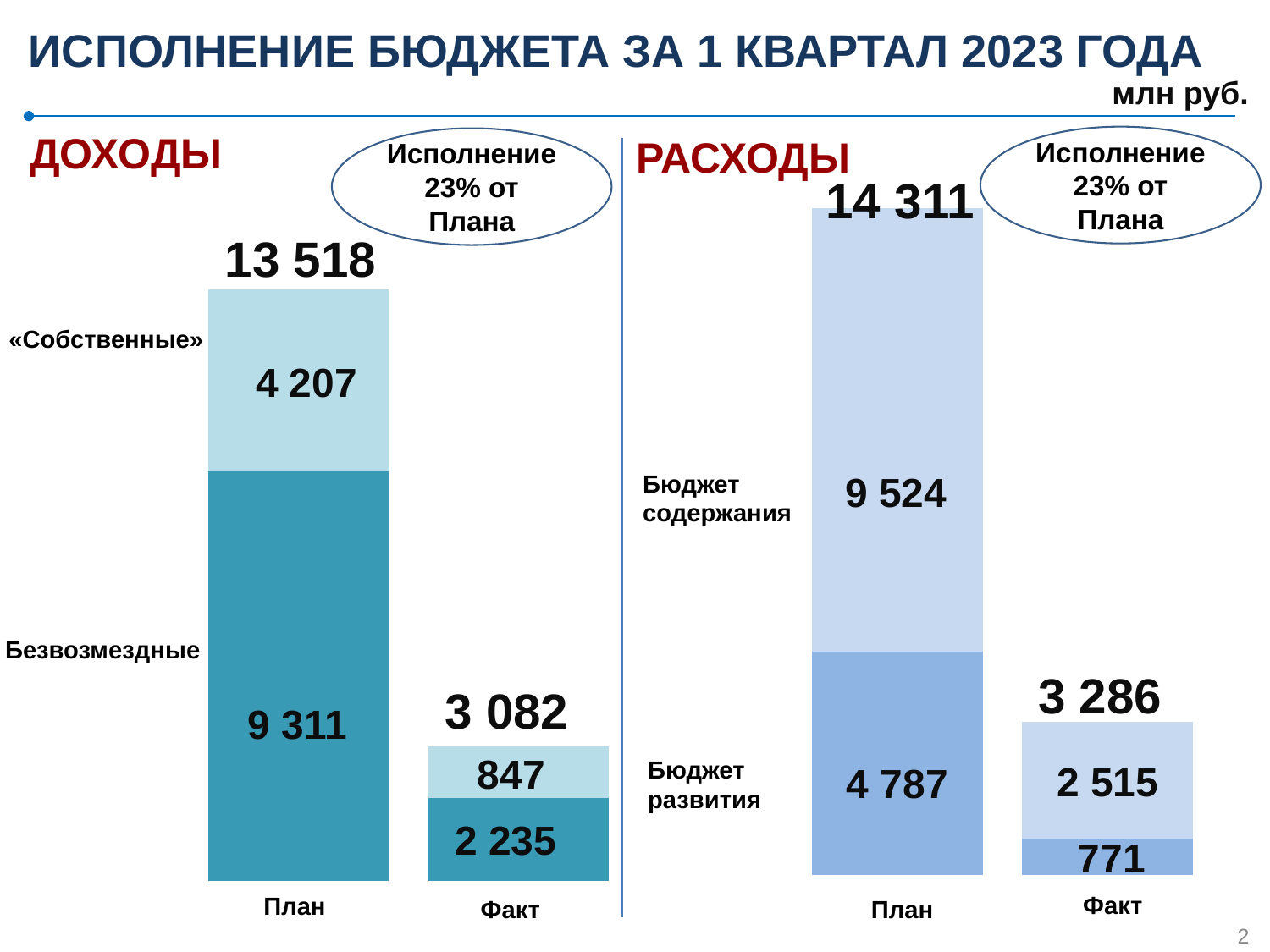
In the ДОХОДЫ chart, what is the value of Безвозмездные for Факт? 2 235 In the ДОХОДЫ chart, what is the total of the План bar? 13 518 In the РАСХОДЫ chart, what is the value of Бюджет содержания for План? 9 524 In the РАСХОДЫ chart, what is the value of Бюджет развития for Факт? 771 What unit of measurement is stated on the slide for the charts? млн руб. In the ДОХОДЫ chart, what is the value of «Собственные» for План? 4 207 What type of chart is the ДОХОДЫ chart? Stacked bar chart In the ДОХОДЫ chart, what is the total of the Факт bar? 3 082 In the РАСХОДЫ chart, what is the difference between Бюджет содержания and Бюджет развития for План? 4 737 In the РАСХОДЫ chart, which bar has the higher total: План or Факт? План In the РАСХОДЫ chart, what is the total of the План bar? 14 311 In the ДОХОДЫ chart, which is larger for План: «Собственные» or Безвозмездные? Безвозмездные